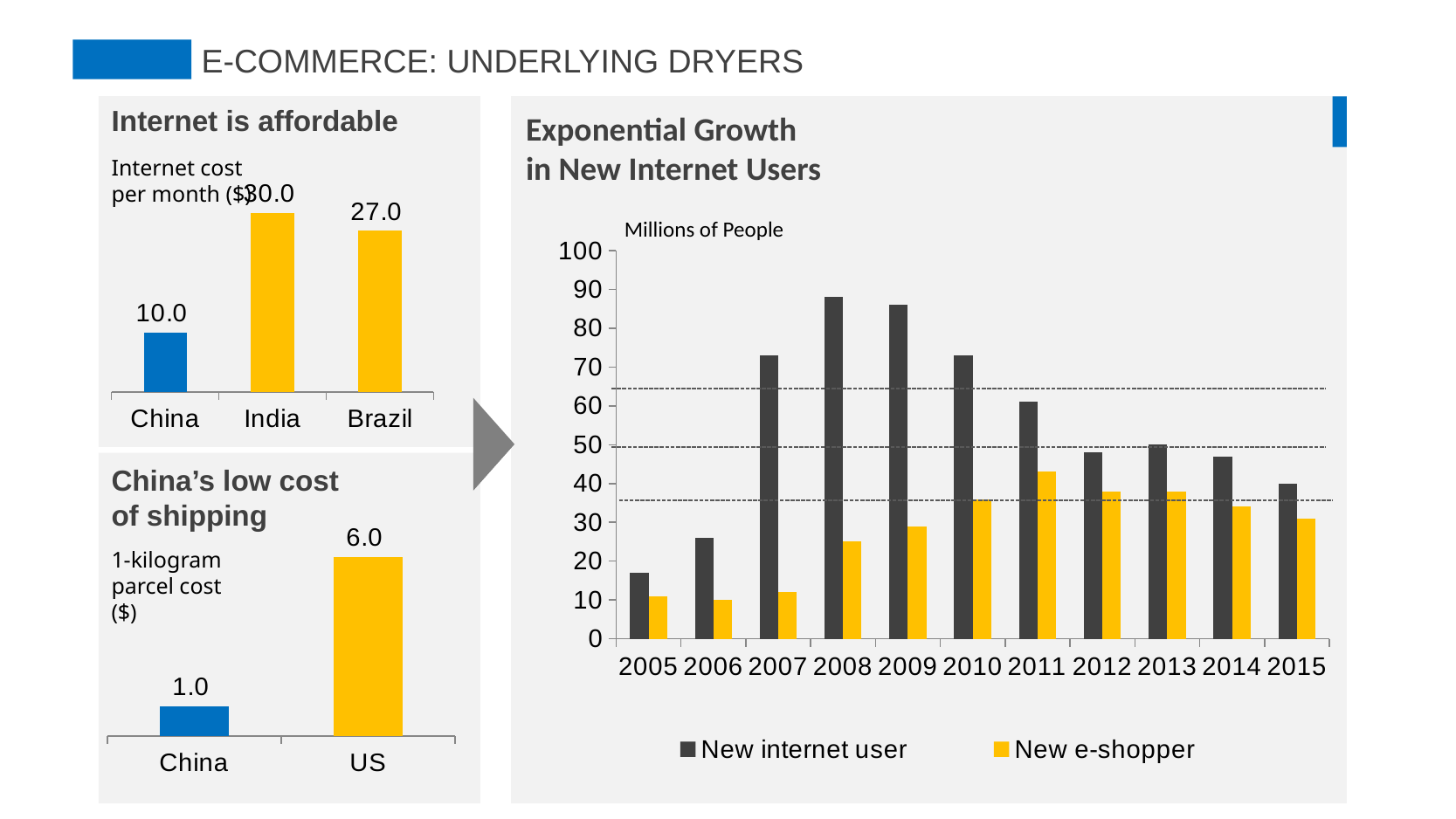
In the 'Exponential Growth in New Internet Users' chart, is the value for New internet user in 2007 greater or less than 70? greater In the 'Internet is affordable' chart, what is the internet cost per month for India? 30.0 What kind of chart is the 'Exponential Growth in New Internet Users' chart? Bar chart In the 'Internet is affordable' chart, what is the difference between the values for India and Brazil? 3.0 In the 'Exponential Growth in New Internet Users' chart, how many series does the legend list? 2 In the 'Exponential Growth in New Internet Users' chart, which year has the highest value for New internet user? 2008 In the 'Internet is affordable' chart, which country has the lowest internet cost per month? China In the 'China's low cost of shipping' chart, what is the 1-kilogram parcel cost for the US? 6.0 In the 'China's low cost of shipping' chart, which is larger, the value for China or the value for the US? US In the 'Exponential Growth in New Internet Users' chart, is the value for New e-shopper in 2005 greater or less than 20? less In the 'China's low cost of shipping' chart, what is the difference between the US and China values? 5.0 In the 'Internet is affordable' chart, how many countries are shown? 3